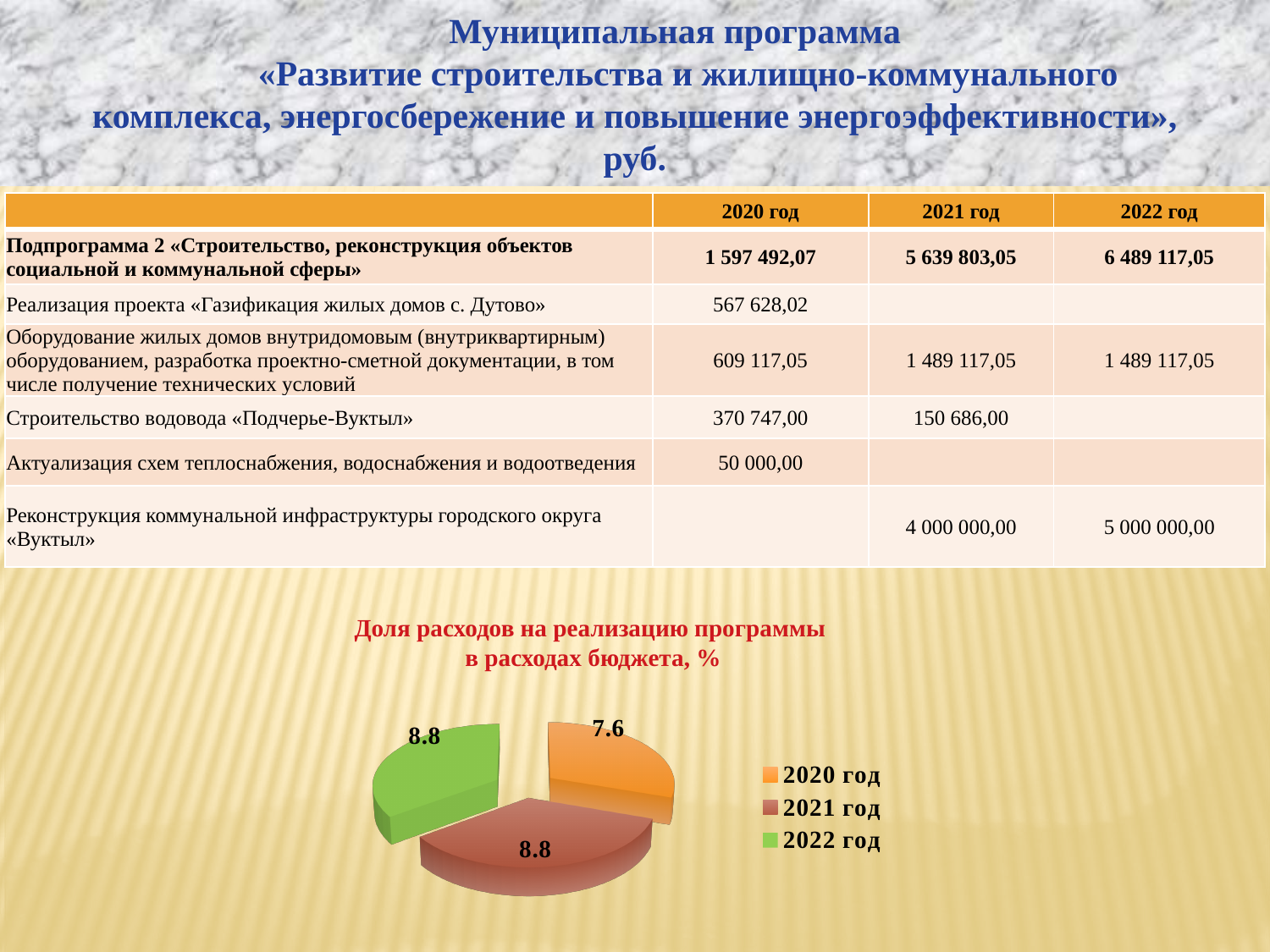
What is the value shown for 2020 год in the pie chart? 7.6 What is the difference between the values for 2021 год and 2020 год in the pie chart? 1.2 What is the title of the pie chart? Доля расходов на реализацию программы в расходах бюджета, % Which is larger in the pie chart, the value for 2020 год or the value for 2021 год? 2021 год What is the value shown for 2022 год in the pie chart? 8.8 How many entries does the pie chart's legend list? 3 How many slices does the pie chart have? 3 What colour is the slice for 2022 год in the pie chart? green What kind of chart is shown on the slide? pie chart What is the value shown for 2021 год in the pie chart? 8.8 Which year has the smallest slice in the pie chart? 2020 год